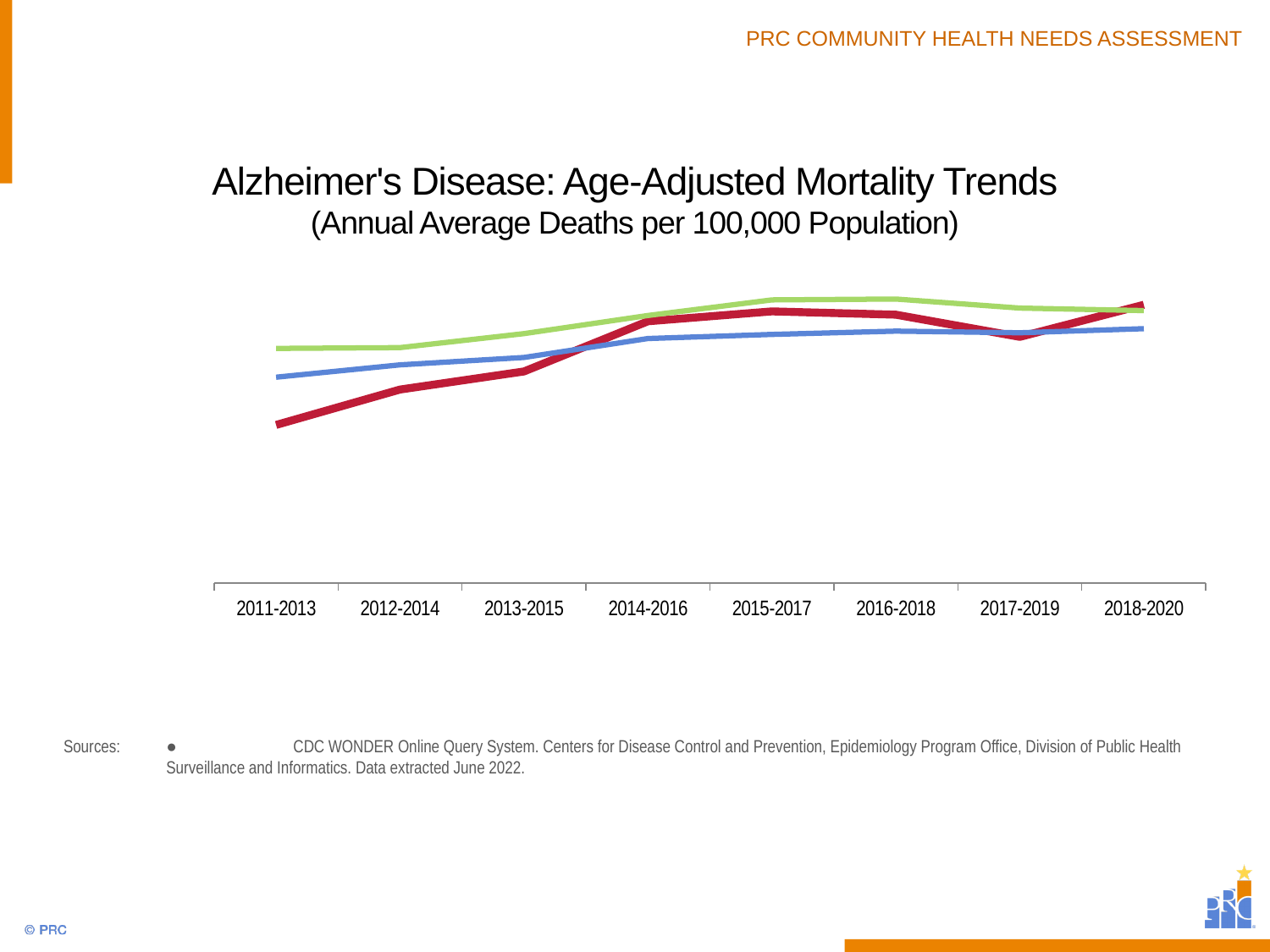
Does the blue line rise or fall overall from 2011-2013 to 2018-2020? Rises At 2011-2013, which line is the lowest? Red What is the first time period shown on the x axis? 2011-2013 What is the title of the chart? Alzheimer's Disease: Age-Adjusted Mortality Trends How many time periods are shown along the x axis? 8 At 2012-2014, is the green line above or below the red line? Above What kind of chart is shown on the slide? Line chart At 2011-2013, which line is the highest? Green Does the red line rise or fall overall from 2011-2013 to 2018-2020? Rises At 2018-2020, is the red line above or below the blue line? Above What unit does the chart subtitle say the values are measured in? Annual Average Deaths per 100,000 Population How many lines are plotted on the chart? 3